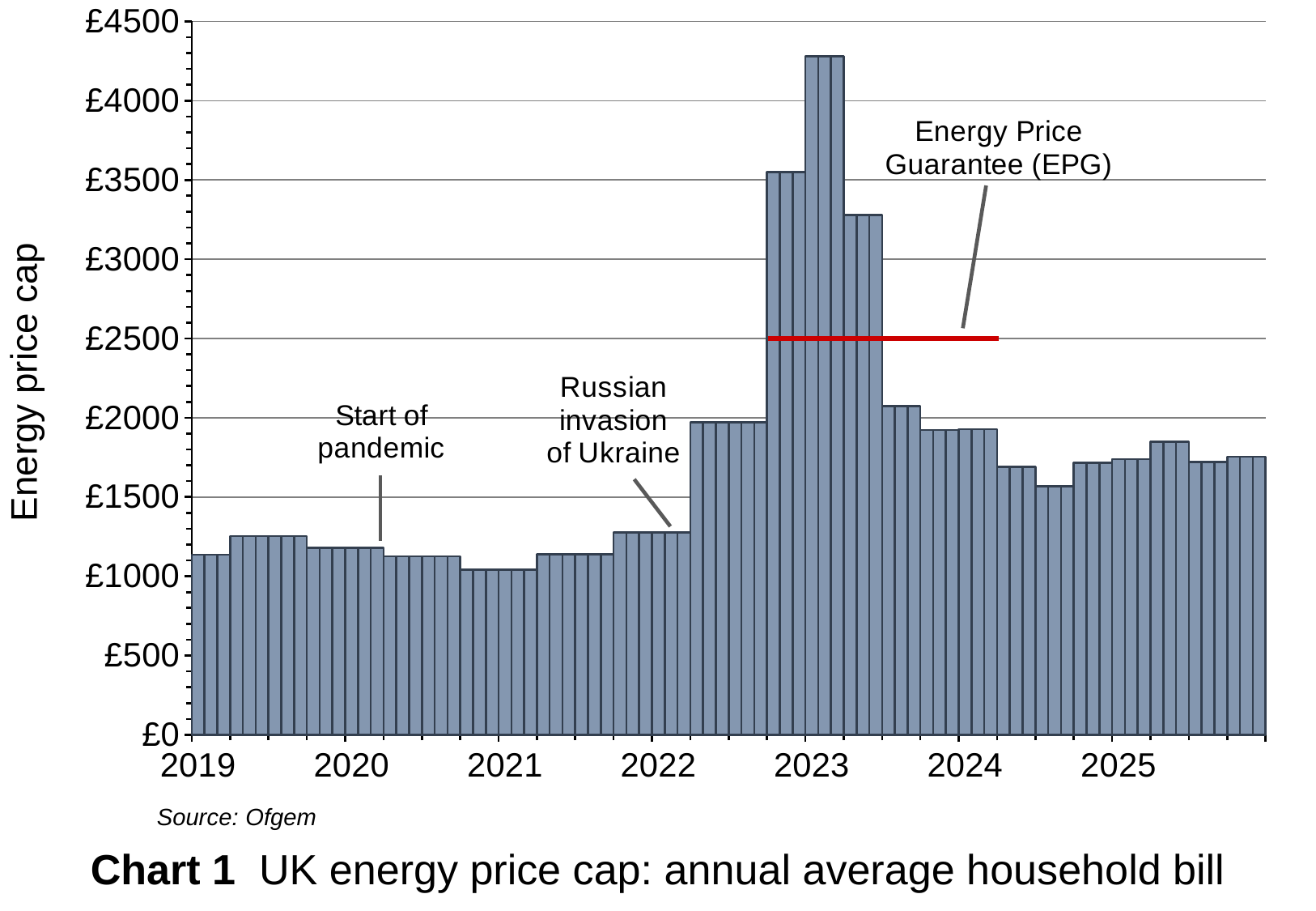
Which is larger: the energy price cap at the start of 2022 or at the start of 2021? start of 2022 Is the energy price cap in mid-2023, just after the peak, greater or less than £3000? greater In which year does the energy price cap reach its highest value? 2023 At what level is the Energy Price Guarantee (EPG) line drawn on the chart? £2500 Is the highest value of the energy price cap, in early 2023, greater or less than £4000? greater What kind of chart is Chart 1? bar chart Are the energy price cap values during 2025 greater or less than £2000? less Does the energy price cap rise or fall between the start of 2022 and the start of 2023? rise What is the label on the vertical axis of the chart? Energy price cap Does the energy price cap rise or fall between the peak in early 2023 and the start of 2024? fall What is the title of the chart? Chart 1 UK energy price cap: annual average household bill